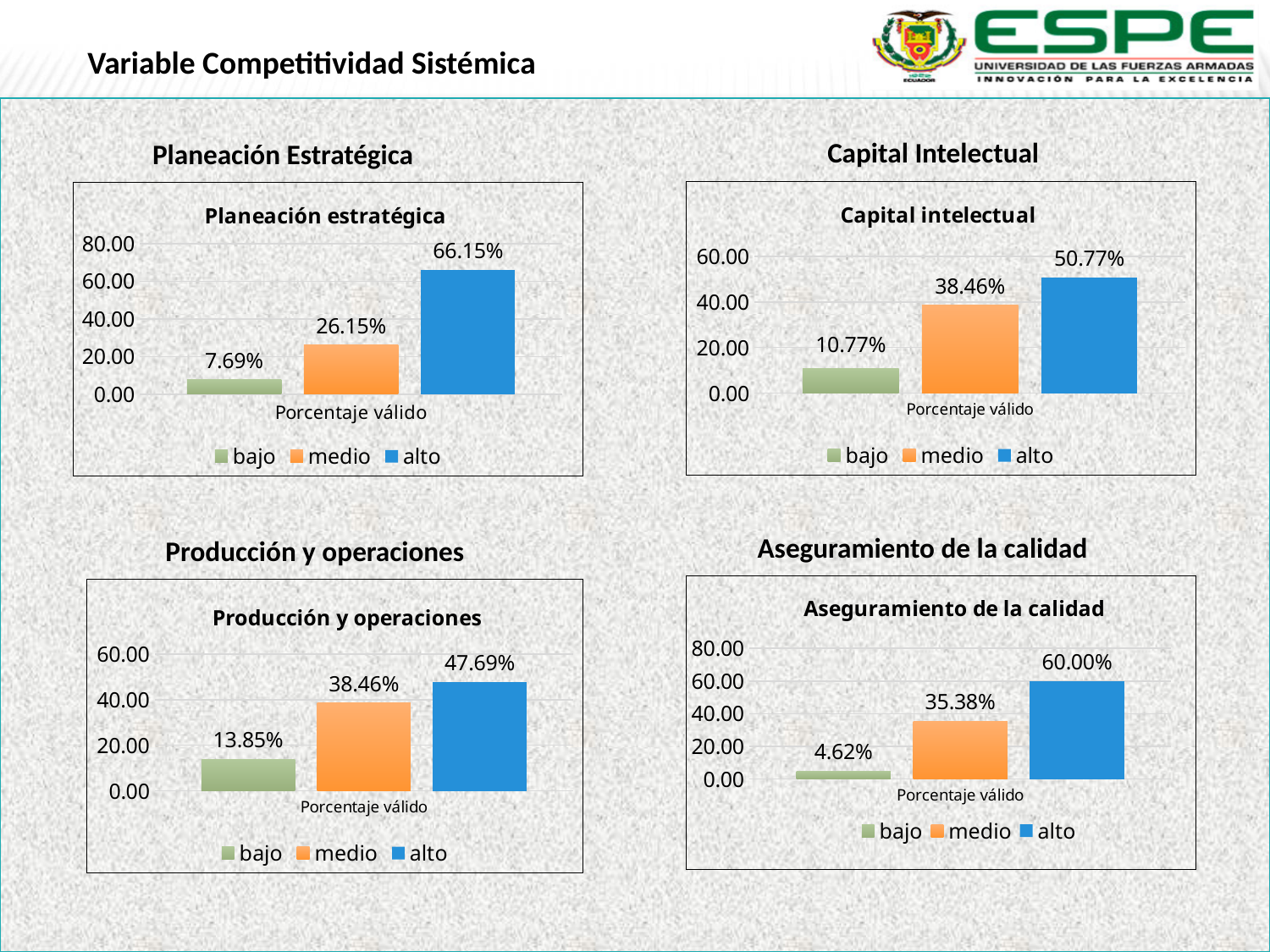
What kind of chart is the 'Producción y operaciones' chart? bar chart In the 'Aseguramiento de la calidad' chart, is the value for 'medio' greater or less than 40.00? less How many series does the legend list in the 'Capital intelectual' chart? 3 In the 'Aseguramiento de la calidad' chart, what is the value for 'alto'? 60.00% In the 'Producción y operaciones' chart, which is larger, 'alto' or 'bajo'? alto In the 'Producción y operaciones' chart, what is the value for 'medio'? 38.46% In the 'Planeación estratégica' chart, what is the value for 'alto'? 66.15% In the 'Aseguramiento de la calidad' chart, which series has the lowest value? bajo In the 'Capital intelectual' chart, which series has the highest value? alto In the 'Planeación estratégica' chart, what colour is the 'medio' bar? orange In the 'Capital intelectual' chart, what is the value for 'bajo'? 10.77% In the 'Planeación estratégica' chart, what is the difference between the 'alto' and 'medio' values? 40.00%